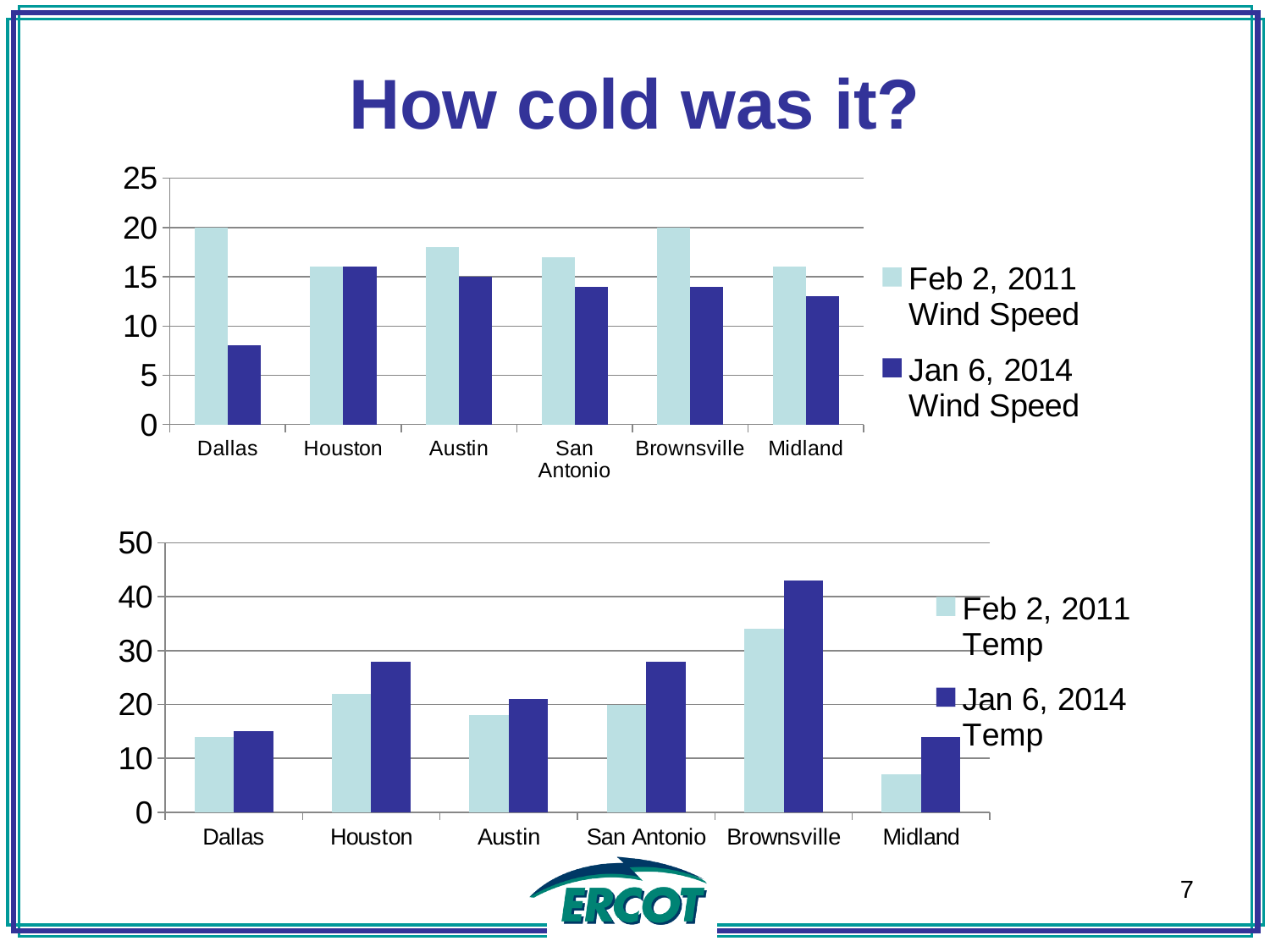
In the bottom chart (temperature), which city has the lowest Feb 2, 2011 Temp? Midland In the bottom chart (temperature), is the Jan 6, 2014 Temp for Brownsville greater or less than 40? greater In the top chart (wind speed), which city has the lowest Jan 6, 2014 Wind Speed? Dallas In the bottom chart (temperature), which is larger for Houston: the Feb 2, 2011 Temp or the Jan 6, 2014 Temp? Jan 6, 2014 Temp In the bottom chart (temperature), is the Feb 2, 2011 Temp for Midland greater or less than 10? less In the bottom chart (temperature), how many cities are shown on the x axis? 6 In the top chart (wind speed), how many series does the legend list? 2 What kind of chart is the top chart on the slide? bar chart What are the two legend entries of the bottom chart? Feb 2, 2011 Temp and Jan 6, 2014 Temp In the bottom chart (temperature), which city has the highest Jan 6, 2014 Temp? Brownsville In the top chart (wind speed), is the Jan 6, 2014 Wind Speed for Dallas greater or less than 10? less In the top chart (wind speed), which is larger for Dallas: the Feb 2, 2011 Wind Speed or the Jan 6, 2014 Wind Speed? Feb 2, 2011 Wind Speed